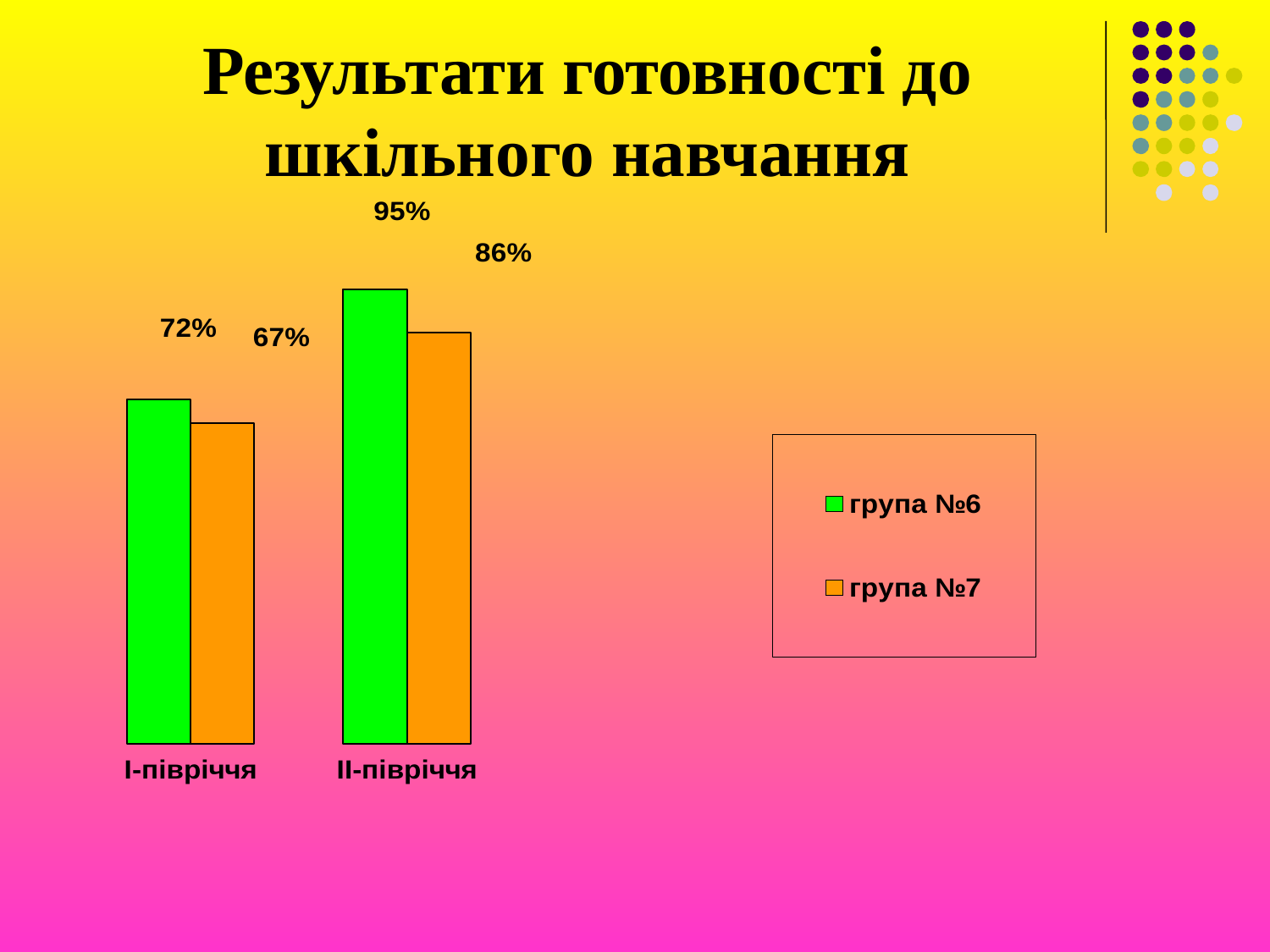
Which series has the lowest value in І-півріччя? група №7 What is the value for група №7 in ІІ-півріччя? 86% How many series does the legend list? 2 What is the value for група №6 in ІІ-півріччя? 95% What kind of chart is shown on the slide? bar chart Which series has the highest value in ІІ-півріччя? група №6 Which is larger: група №7 in ІІ-півріччя or група №6 in І-півріччя? група №7 in ІІ-півріччя What is the difference between група №6 and група №7 in ІІ-півріччя? 9% What is the value for група №6 in І-півріччя? 72% What is the value for група №7 in І-півріччя? 67% How many categories are shown on the x axis? 2 What is the difference between група №6 in ІІ-півріччя and група №6 in І-півріччя? 23%